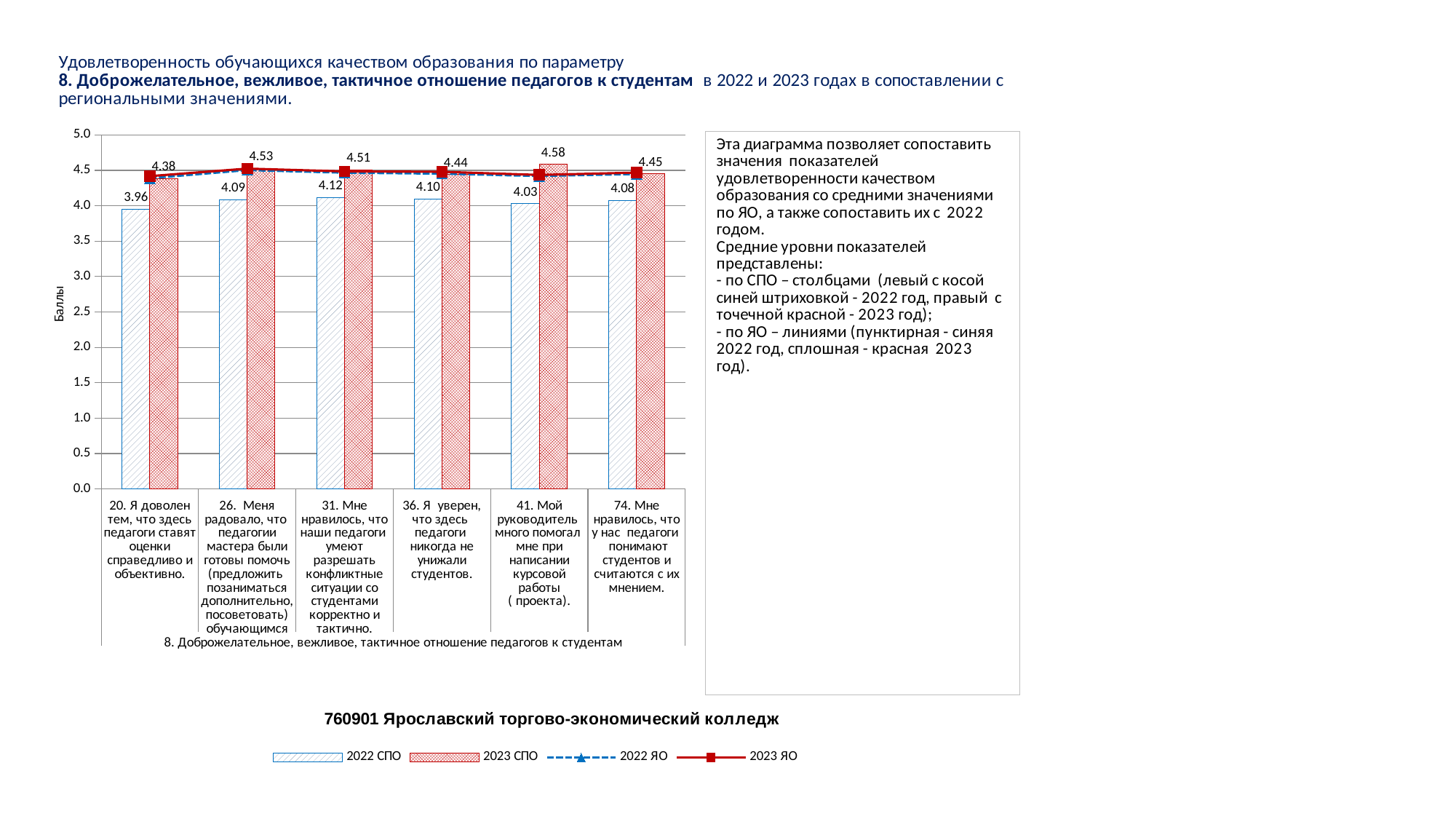
Which category has the highest 2023 СПО value? 41. Мой руководитель много помогал мне при написании курсовой работы ( проекта). How many categories are shown on the x axis of the chart? 6 What is the 2023 СПО value for category "26. Меня радовало, что педагогии мастера были готовы помочь..."? 4.53 What kind of chart is shown on the slide? Combined bar and line chart Is the 2022 СПО value for category "31. Мне нравилось, что наши педагоги умеют разрешать конфликтные ситуации со студентами корректно и тактично." greater or less than 4.5? less Which is larger for category "74. Мне нравилось, что у нас педагоги понимают студентов и считаются с их мнением.": the 2022 СПО value or the 2023 СПО value? 2023 СПО What is the 2023 СПО value for category "41. Мой руководитель много помогал мне при написании курсовой работы ( проекта)."? 4.58 What is the difference between the 2023 СПО and 2022 СПО values for category "41. Мой руководитель много помогал мне при написании курсовой работы ( проекта)."? 0.55 Which category has the lowest 2022 СПО value? 20. Я доволен тем, что здесь педагоги ставят оценки справедливо и объективно. What is the label of the vertical axis of the chart? Баллы How many series does the chart legend list? 4 What is the 2022 СПО value for category "20. Я доволен тем, что здесь педагоги ставят оценки справедливо и объективно."? 3.96